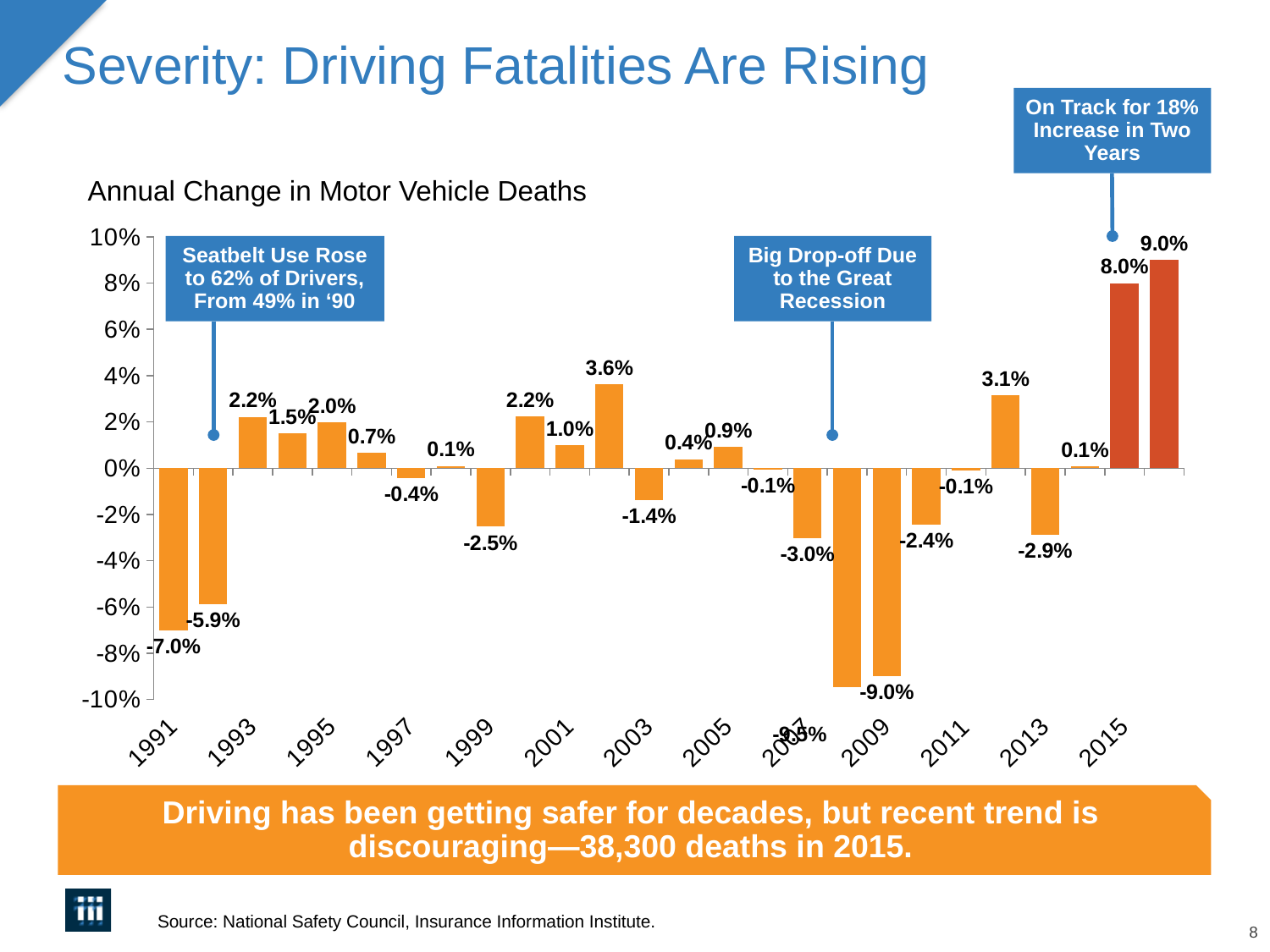
What kind of chart is shown on the slide? Bar chart How many bars are plotted in the chart? 26 What is the value of the highest bar in the chart? 9.0% Which year has the larger annual change, 1993 or 2011? 1993 What value is shown for 2009 in the Annual Change in Motor Vehicle Deaths chart? -9.0% What is the annual change in motor vehicle deaths shown for 1991? -7.0% What is the annual change in motor vehicle deaths for 2015? 8.0% Is the value for 2015 greater or less than 6%? greater What value does the chart show for 2013? -2.9% What is the title of the chart? Annual Change in Motor Vehicle Deaths What is the difference between the values for 2015 and 2013? 10.9 percentage points What is the annual change in motor vehicle deaths for 2003? -1.4%